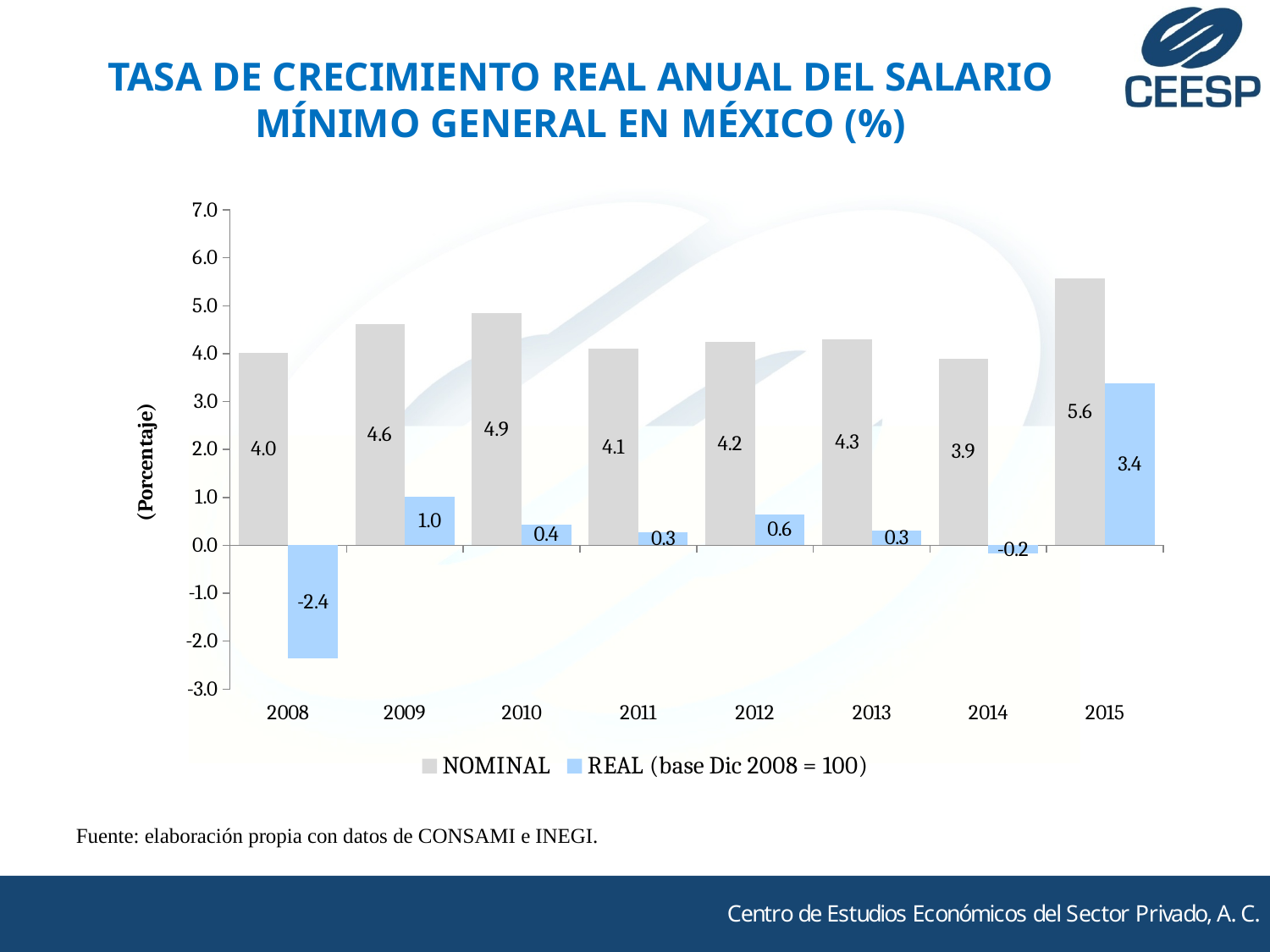
What is the NOMINAL value for 2015? 5.6 What is the difference between the NOMINAL and REAL values for 2015? 2.2 Which year has the lowest REAL (base Dic 2008 = 100) value? 2008 What kind of chart is shown on the slide? Bar chart Which year has the lowest NOMINAL value? 2014 Which year has the highest NOMINAL value? 2015 What is the NOMINAL value for 2010? 4.9 What is the REAL (base Dic 2008 = 100) value for 2008? -2.4 How many years are shown on the x axis? 8 Which is larger, the REAL value for 2009 or the REAL value for 2012? 2009 How many series does the legend list? 2 What is the REAL (base Dic 2008 = 100) value for 2014? -0.2